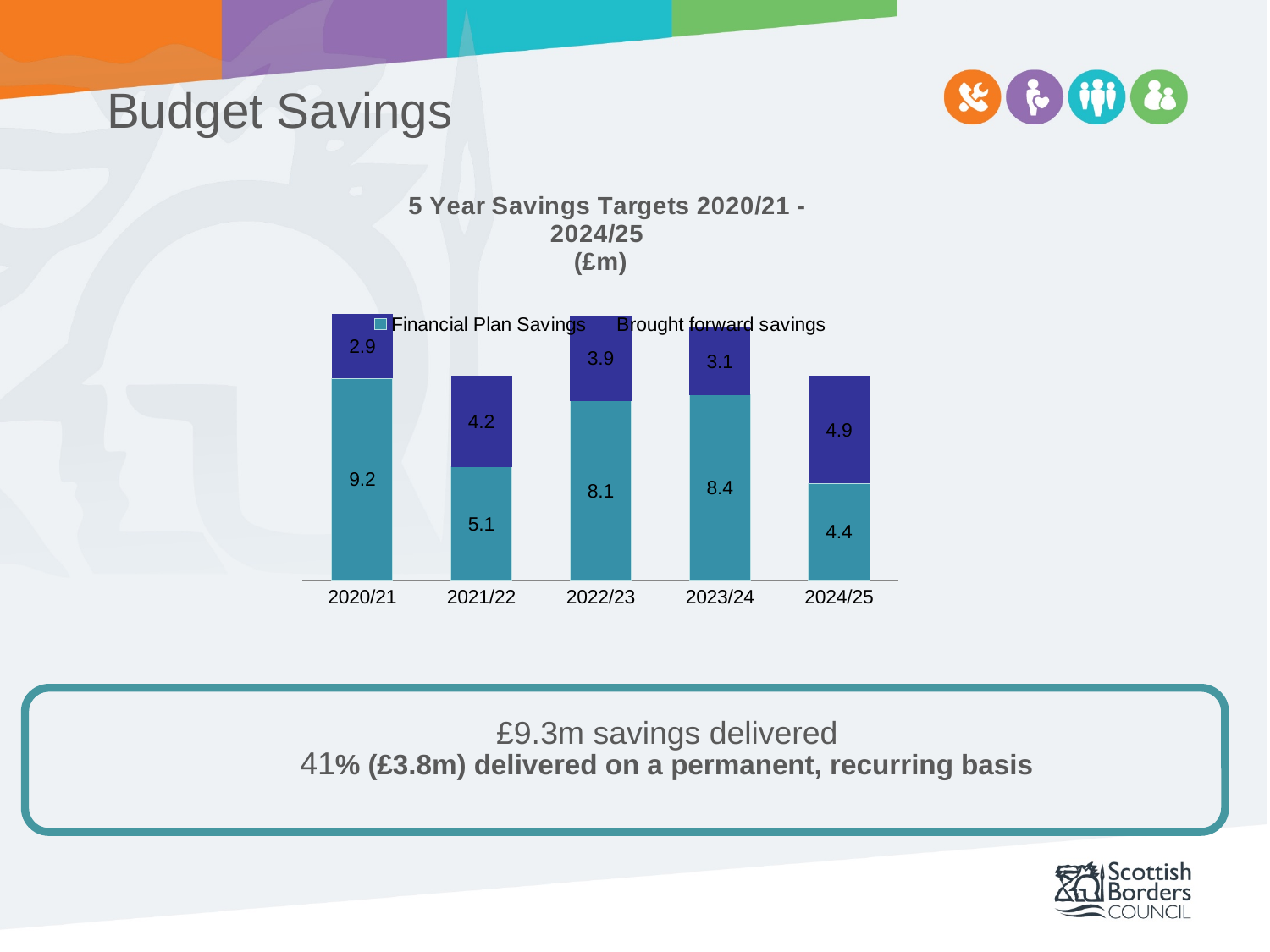
Which year has the highest Financial Plan Savings value? 2020/21 Which year has the lowest Brought forward savings value? 2020/21 How many years are shown on the x axis? 5 Which is larger, the Financial Plan Savings value for 2022/23 or for 2023/24? 2023/24 Which year has the highest Brought forward savings value? 2024/25 What is the Financial Plan Savings value for 2024/25? 4.4 What is the difference between the Financial Plan Savings values for 2020/21 and 2024/25? 4.8 What is the total of the stacked bar for 2021/22? 9.3 What is the Brought forward savings value for 2023/24? 3.1 How many series does the legend list? 2 What is the Financial Plan Savings value for 2021/22? 5.1 What kind of chart is shown on the slide? Stacked bar chart